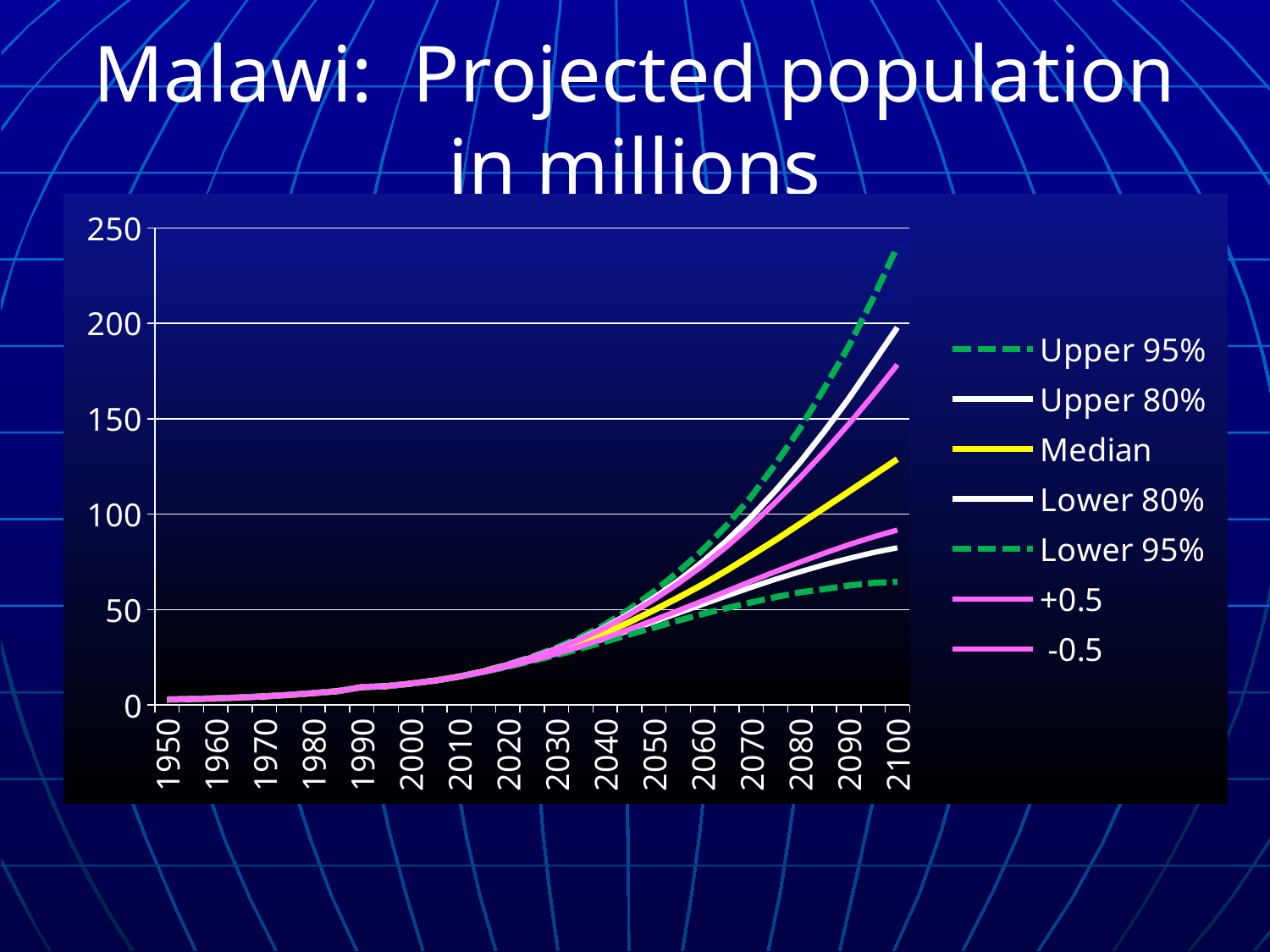
Is the Median value in 2100 greater or less than 150? less Which is larger in 2100, the Median or the -0.5 series? Median Which series has the lowest value in 2100? Lower 95% Is the Lower 95% value in 2100 greater or less than 100? less How many series does the legend list? 7 Do the projected population values rise or fall from 1950 to 2100? rise Which series reaches the highest value in 2100? Upper 95% How many year labels are shown along the x axis? 16 Is the Upper 95% value in 2100 greater or less than 200? greater What kind of chart is shown on the slide? line chart What is the title of the chart? Malawi: Projected population in millions